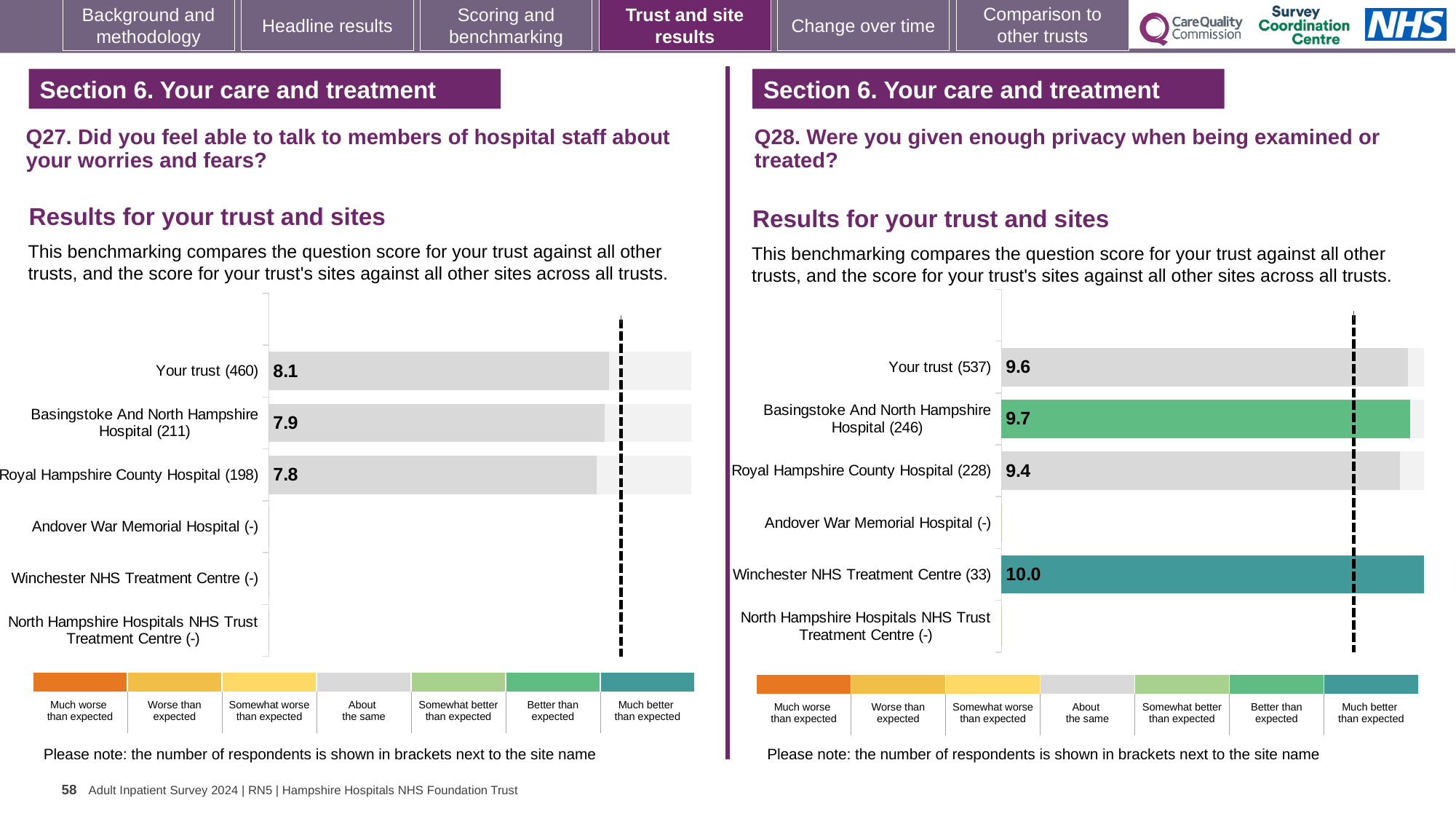
On the Q27 chart (left), which site or trust has the highest score? Your trust On the Q27 chart (left), what is the score for Your trust? 8.1 On the Q28 chart (right), which is larger: the score for Your trust or the score for Basingstoke And North Hampshire Hospital? Basingstoke And North Hampshire Hospital On the Q27 chart (left), what is the score for Royal Hampshire County Hospital? 7.8 On the Q28 chart (right), what is the score for Winchester NHS Treatment Centre? 10.0 What kind of chart is used on the Q27 chart (left)? Bar chart On the Q27 chart (left), what is the difference between the scores for Your trust and Royal Hampshire County Hospital? 0.3 On the Q28 chart (right), how many sites or trusts have a plotted bar with a score? 4 On the Q27 chart (left), how many respondents are shown for Basingstoke And North Hampshire Hospital? 211 On the Q28 chart (right), what is the difference between the scores for Winchester NHS Treatment Centre and Royal Hampshire County Hospital? 0.6 On the Q28 chart (right), what is the score for Basingstoke And North Hampshire Hospital? 9.7 On the Q28 chart (right), which site has the lowest score among those with a plotted value? Royal Hampshire County Hospital